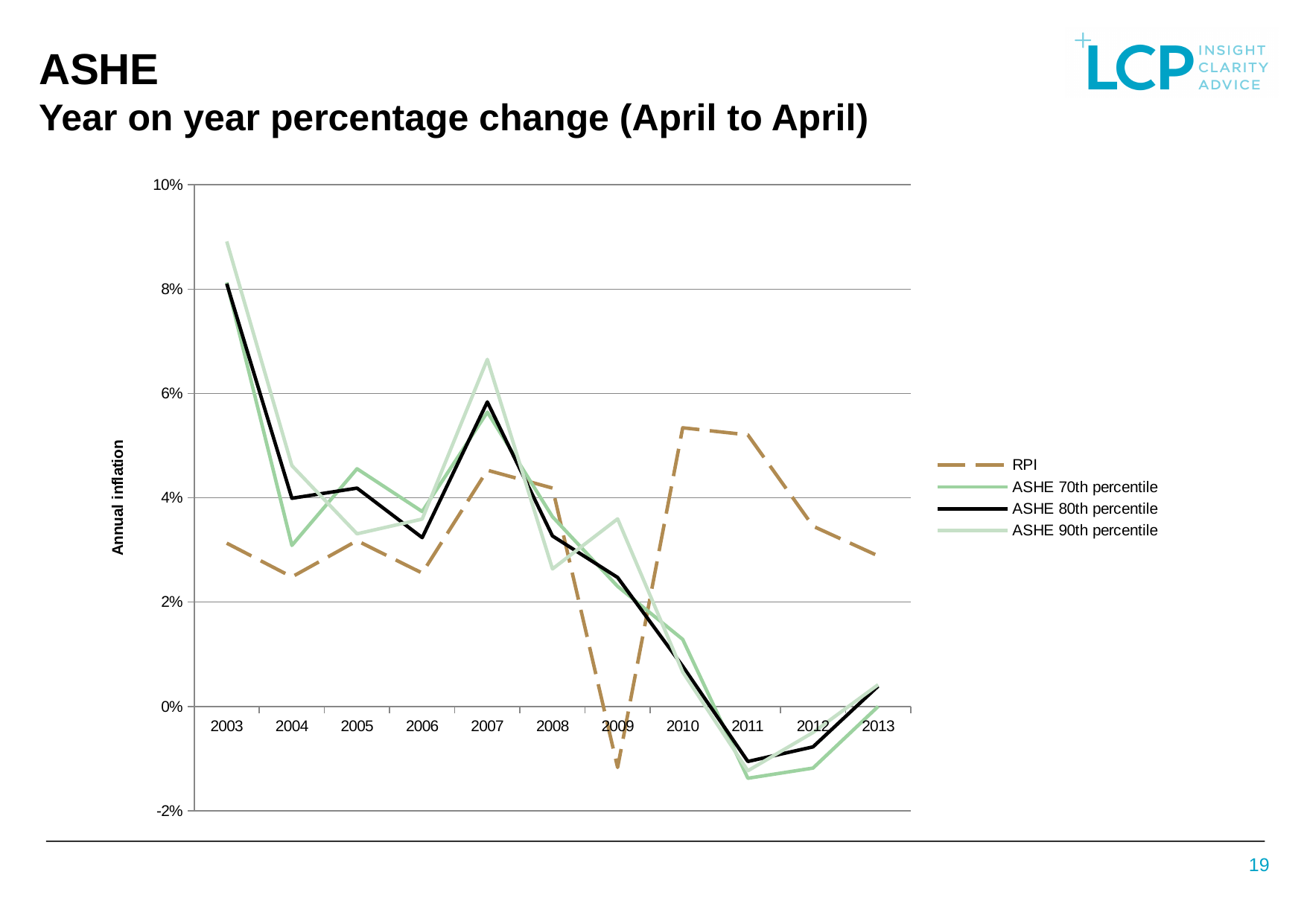
How many years are plotted along the x axis? 11 What kind of chart is shown on the slide? line chart Is the value for ASHE 70th percentile in 2007 greater or less than 4%? greater Is the value for RPI in 2009 greater or less than 0%? less In which year is the ASHE 80th percentile line at its lowest? 2011 How many series does the legend list? 4 Is the value for ASHE 90th percentile in 2003 greater or less than 8%? greater In 2010, which is larger: RPI or ASHE 80th percentile? RPI Which series is drawn as a dashed line? RPI Does the ASHE 80th percentile line rise or fall from 2007 to 2011? fall In which year is the ASHE 80th percentile line at its highest? 2003